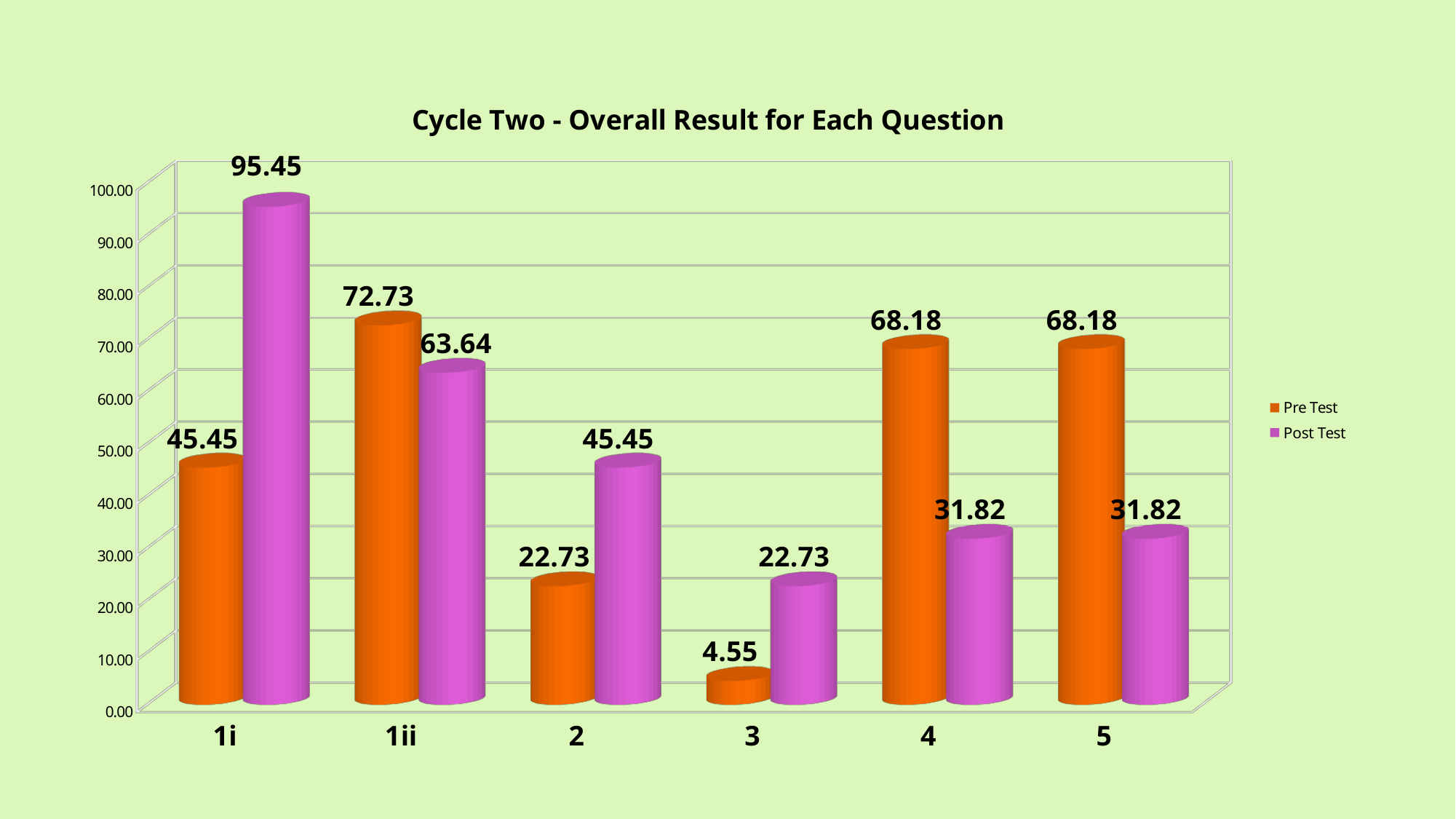
What is the Pre Test value for question 1ii? 72.73 Which question has the lowest Pre Test value? 3 What is the Pre Test value for question 3? 4.55 What is the Post Test value for question 1i? 95.45 How many questions are shown on the x axis? 6 Which is larger for question 4, the Pre Test or the Post Test value? Pre Test Is the Post Test value for question 2 greater or less than 40.00? greater What is the title of the chart? Cycle Two - Overall Result for Each Question How many series does the legend list? 2 Which question has the highest Post Test value? 1i What is the difference between the Post Test and Pre Test values for question 1i? 50.00 What kind of chart is shown? bar chart